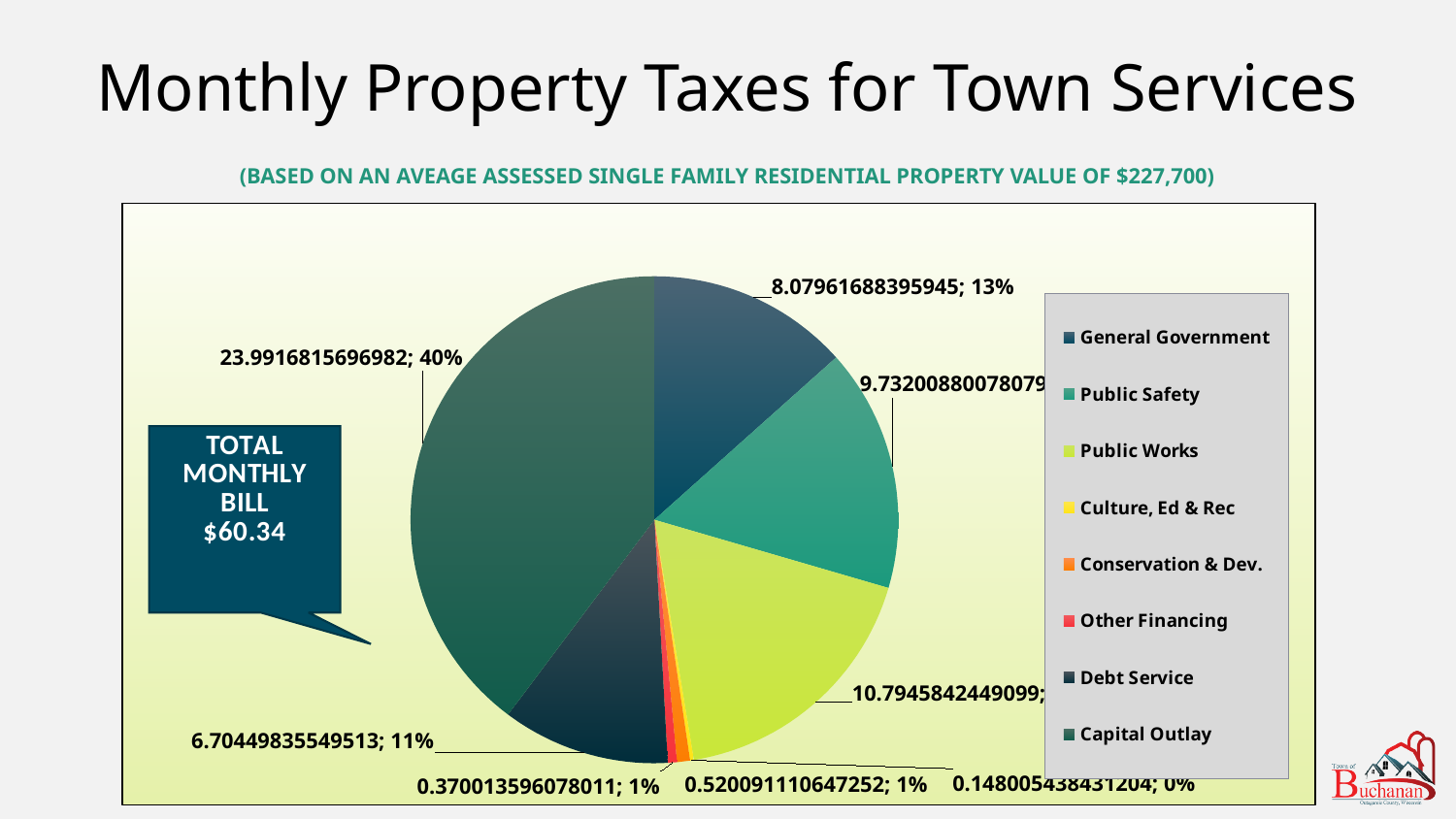
What is the value shown for Public Safety in the pie chart? 9.73200880078079 Which category has the largest slice of the pie chart? Capital Outlay What kind of chart is shown on the slide? Pie chart Which is larger in the pie chart, General Government or Debt Service? General Government What share of the pie does Capital Outlay represent? 40% What is the value shown for Debt Service in the pie chart? 6.70449835549513 What percentage of the pie is General Government? 13% What percentage of the pie is Debt Service? 11% By how many percentage points does Capital Outlay's share exceed General Government's share? 27 percentage points What total monthly bill is shown in the callout box next to the pie chart? $60.34 What is the value shown for General Government in the pie chart? 8.07961688395945 How many categories does the legend of the pie chart list? 8